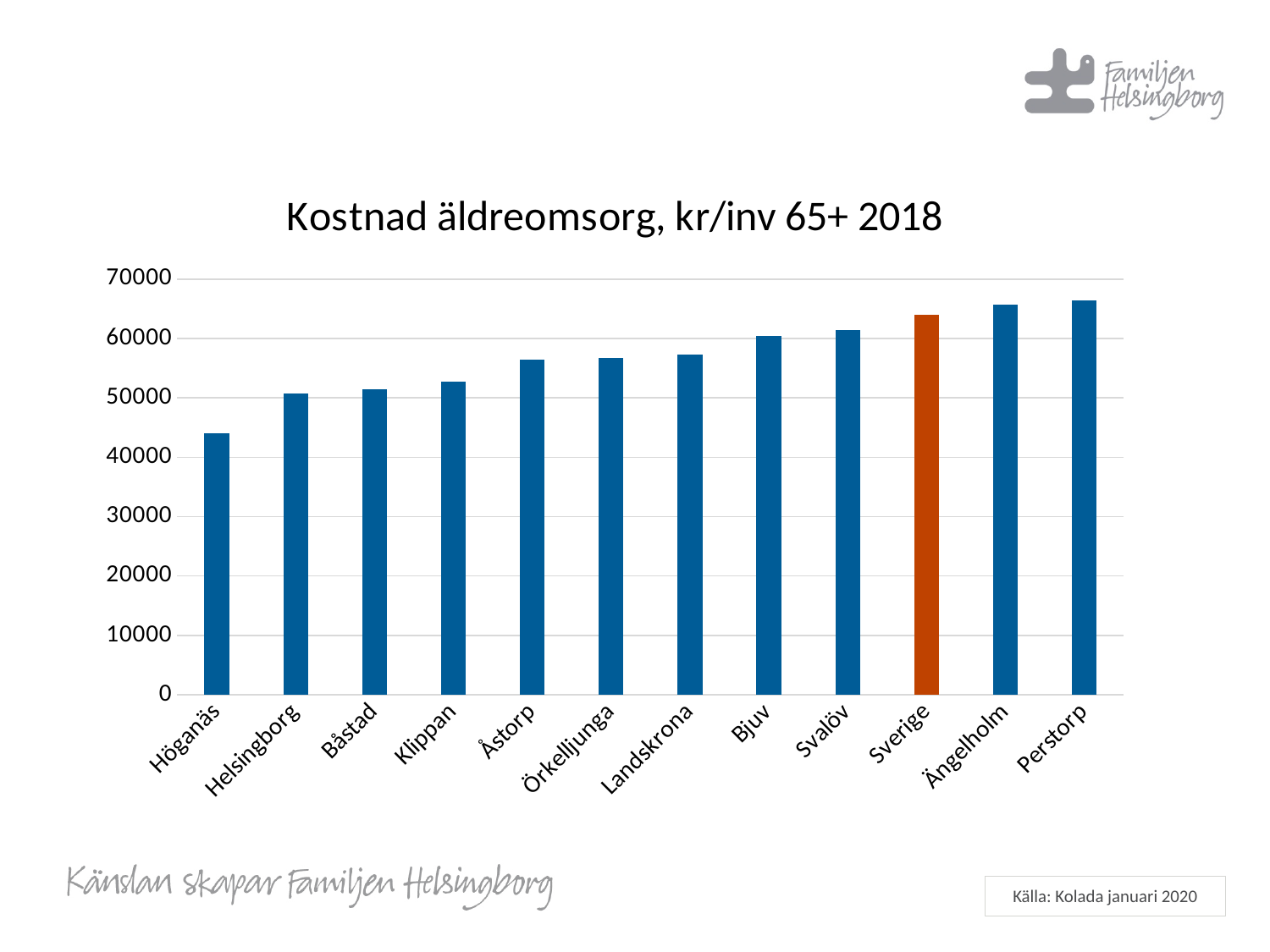
What kind of chart is shown on the slide? Bar chart Which category's bar is shown in a different colour (orange) from the others? Sverige Which has the larger value, Klippan or Bjuv? Bjuv Is the value for Sverige greater or less than 60000? greater Do the values rise or fall from left to right along the x axis? Rise Is the value for Klippan greater or less than 60000? less What is the title of the chart? Kostnad äldreomsorg, kr/inv 65+ 2018 Which has the larger value, Höganäs or Perstorp? Perstorp Is the value for Åstorp greater or less than 50000? greater Which category has the lowest value in the chart? Höganäs How many categories are shown on the x axis of the chart? 12